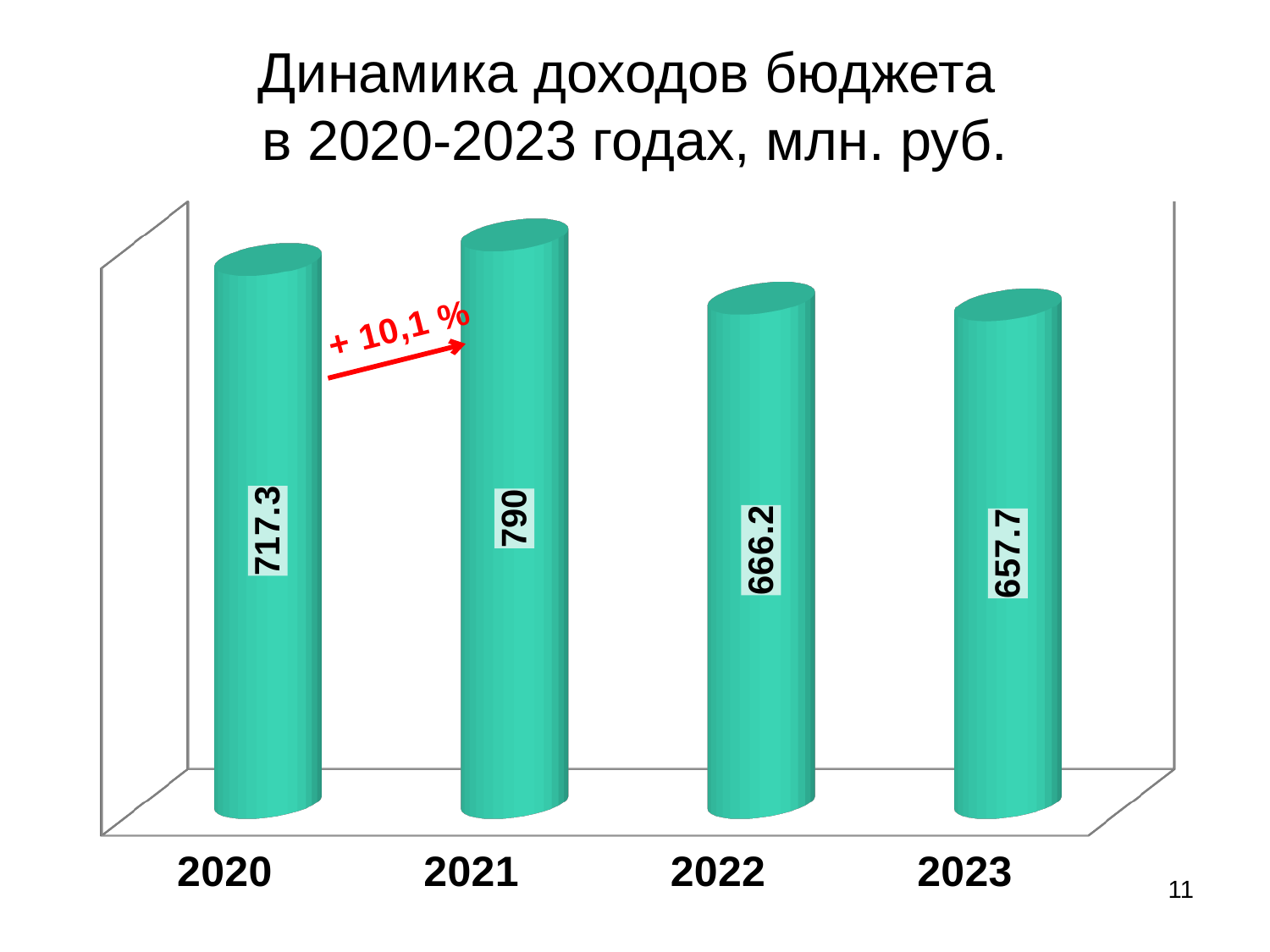
What kind of chart is shown on the slide? Bar chart What percentage change is written next to the red arrow between 2020 and 2021? + 10,1 % What is the difference between the values for 2021 and 2020? 72.7 Which is larger, the value for 2020 or the value for 2022? 2020 Which year has the lowest budget revenue? 2023 How many years are shown on the chart? 4 What is the difference between the values for 2022 and 2023? 8.5 Which year has the highest budget revenue? 2021 Do the values rise or fall from 2021 to 2023? Fall What is the budget revenue value shown for 2021? 790 What is the value shown for 2023? 657.7 What is the value shown for 2020? 717.3